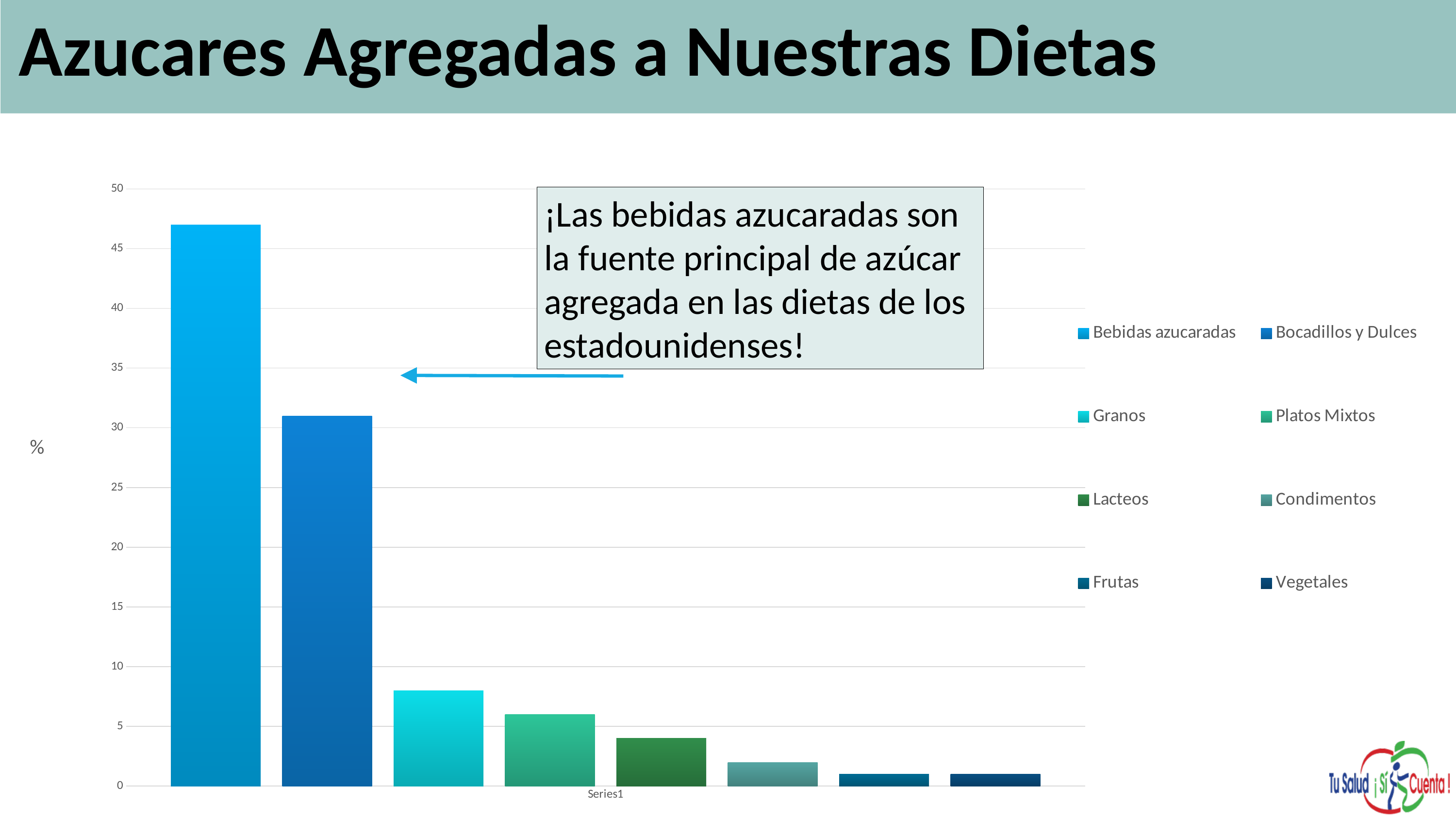
Which series has the highest value in the chart? Bebidas azucaradas How many series does the chart legend list? 8 What is the title of the slide containing the chart? Azucares Agregadas a Nuestras Dietas What label is shown on the vertical axis of the chart? % Which is larger, the value for Granos or the value for Platos Mixtos? Granos Which is larger, the value for Bebidas azucaradas or the value for Bocadillos y Dulces? Bebidas azucaradas Is the value for Lacteos greater or less than 5? less How many bars are plotted in the chart? 8 What kind of chart is shown on the slide? bar chart Is the value for Granos greater or less than 10? less Is the value for Bebidas azucaradas greater or less than 45? greater